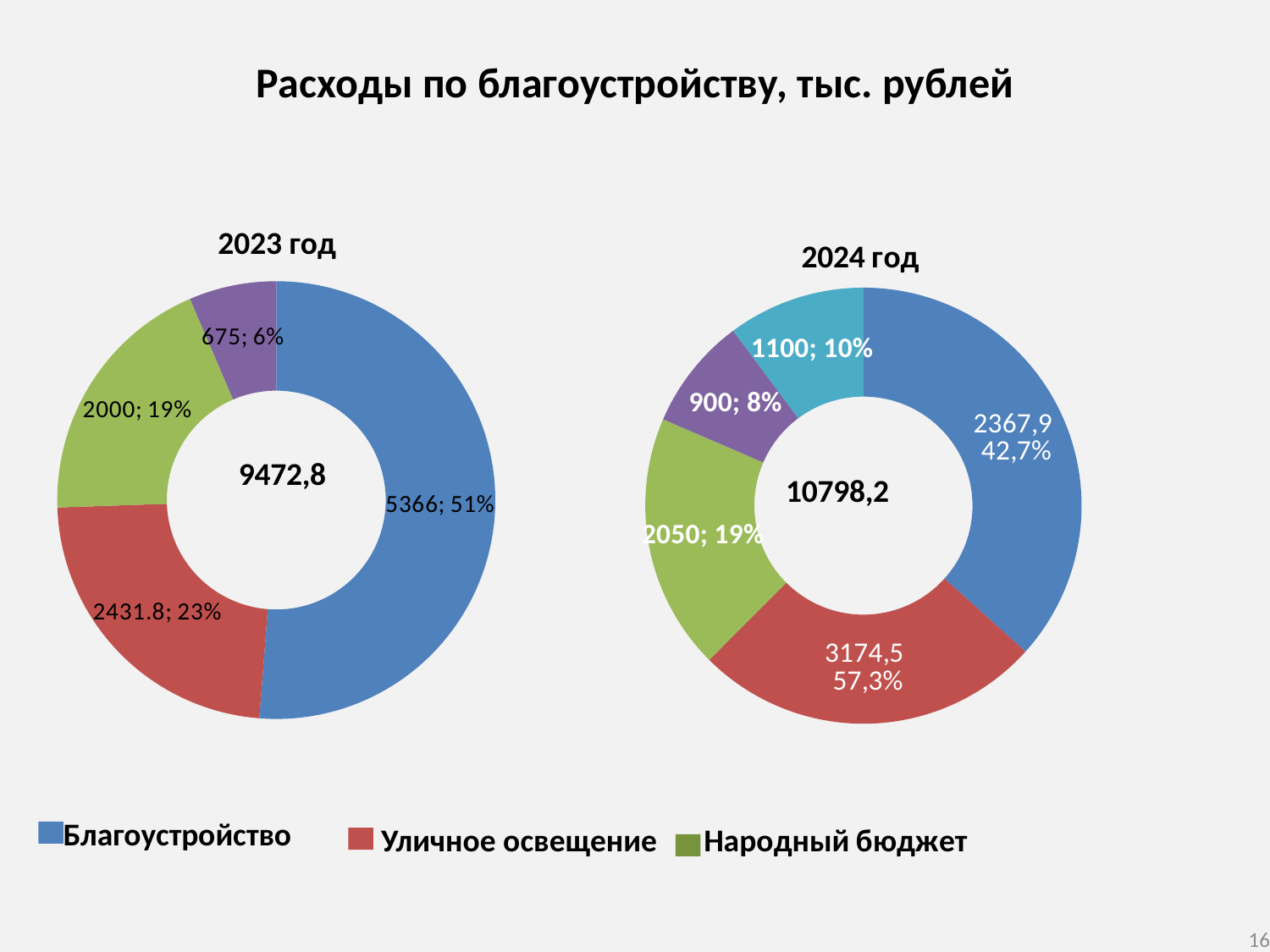
In the 2023 год chart, what value is shown for Благоустройство? 5366; 51% In the 2023 год chart, what value is shown for Уличное освещение? 2431.8; 23% In the 2024 год chart, what value is shown for Народный бюджет? 2050; 19% In the 2023 год chart, what is the difference between Благоустройство and Уличное освещение? 2934.2 What total is shown in the centre of the 2023 год chart? 9472,8 How many entries does the legend list? 3 In the 2023 год chart, which category has the largest slice? Благоустройство How many slices does the 2024 год chart have? 5 What total is shown in the centre of the 2024 год chart? 10798,2 In the 2024 год chart, what value is shown for Уличное освещение? 3174,5 57,3%